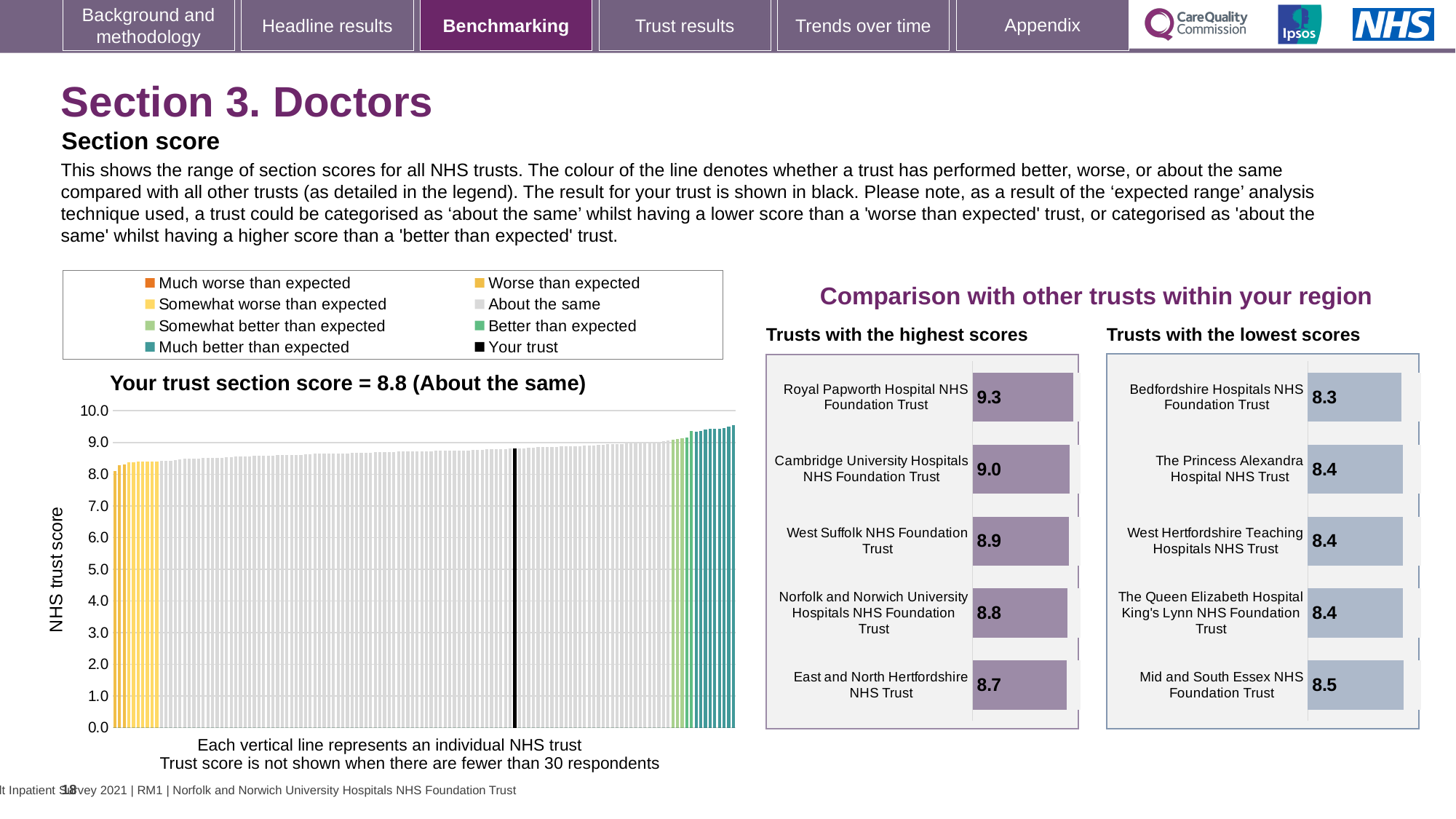
How many trusts are shown in the 'Trusts with the lowest scores' chart? 5 In the 'Trusts with the highest scores' chart, which has the larger score: Cambridge University Hospitals NHS Foundation Trust or Norfolk and Norwich University Hospitals NHS Foundation Trust? Cambridge University Hospitals NHS Foundation Trust In the 'Trusts with the highest scores' chart, what is the difference between the scores of Royal Papworth Hospital NHS Foundation Trust and East and North Hertfordshire NHS Trust? 0.6 In the 'Trusts with the lowest scores' chart, what is the score for Bedfordshire Hospitals NHS Foundation Trust? 8.3 In the 'Trusts with the highest scores' chart, what is the score for West Suffolk NHS Foundation Trust? 8.9 In the 'Trusts with the lowest scores' chart, what is the score for Mid and South Essex NHS Foundation Trust? 8.5 What kind of chart is the 'Your trust section score' chart? Bar chart In the 'Your trust section score' chart, what is the section score for your trust? 8.8 In the 'Trusts with the highest scores' chart, which trust has the highest score? Royal Papworth Hospital NHS Foundation Trust How many entries does the legend above the 'Your trust section score' chart list? 8 In the 'Trusts with the lowest scores' chart, which trust has the lowest score? Bedfordshire Hospitals NHS Foundation Trust In the 'Trusts with the highest scores' chart, what is the score for Royal Papworth Hospital NHS Foundation Trust? 9.3